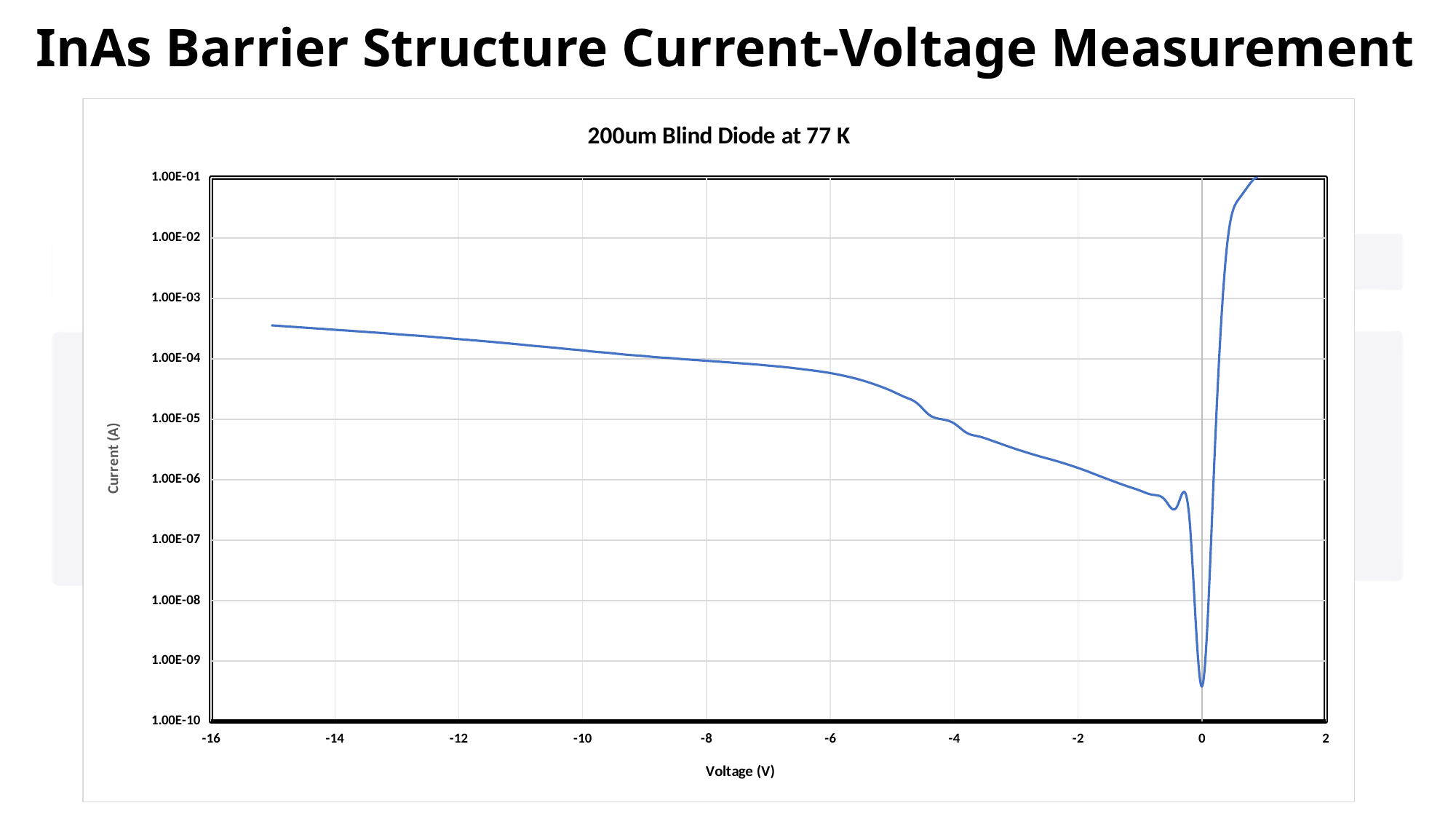
Is the current at -15 V greater or less than 1.00E-04 A? greater What is the label of the y axis? Current (A) What is the title of the chart? 200um Blind Diode at 77 K Is the current at -6 V greater or less than 1.00E-04 A? less Is the current at -2 V greater or less than 1.00E-06 A? greater How many data series are plotted on the chart? 1 What is the lowest value shown on the y axis? 1.00E-10 What kind of chart is shown on the slide? Line chart Does the current rise or fall as the voltage increases from -15 V to -1 V? fall Which is larger, the current at -14 V or the current at -4 V? the current at -14 V